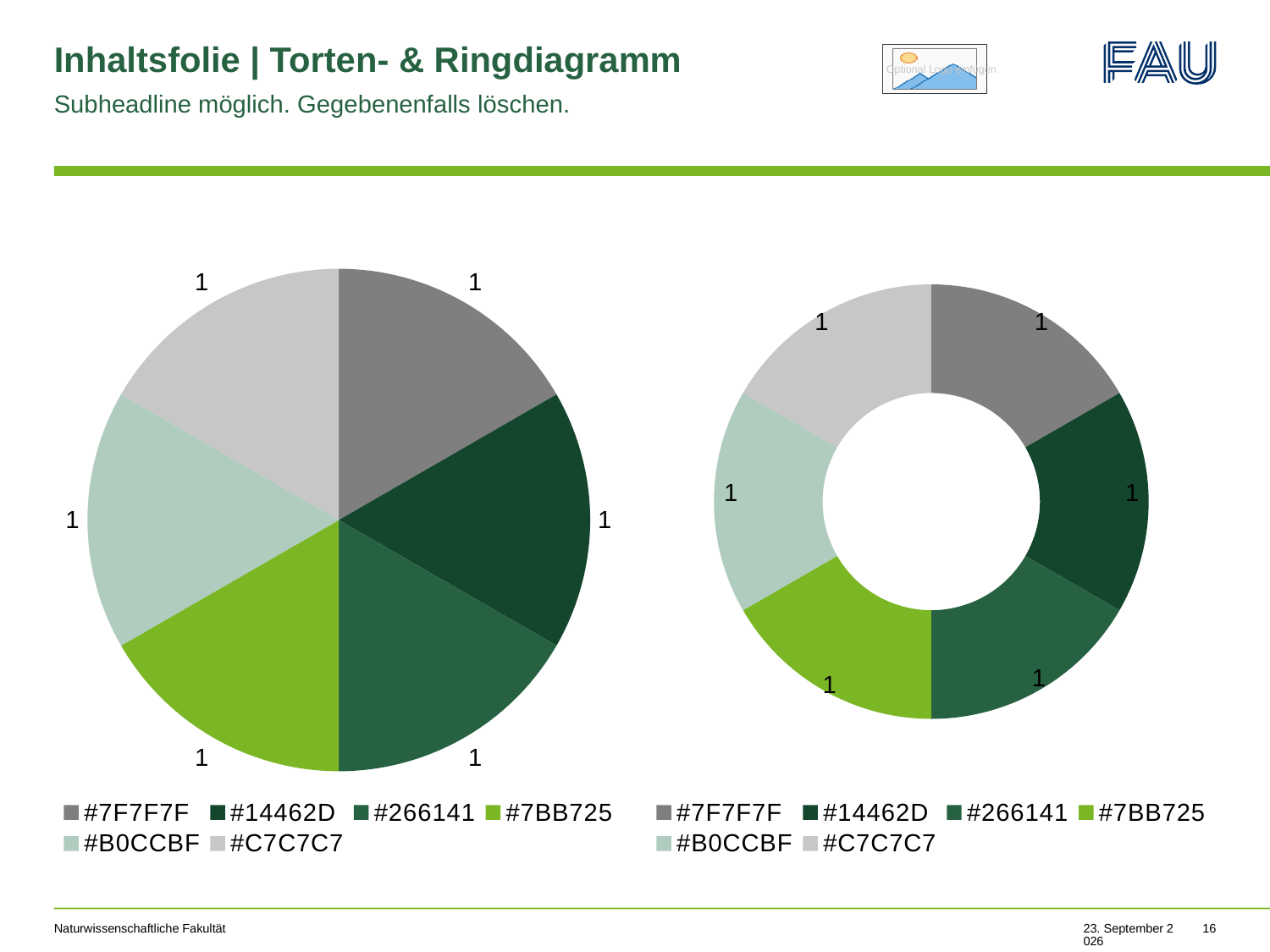
In the doughnut chart on the right, what is the value of the #7BB725 segment? 1 How many entries does the legend of the pie chart on the left list? 6 In the doughnut chart on the right, what is the total of all segment values? 6 In the pie chart on the left, what is the value of the #C7C7C7 slice? 1 In the pie chart on the left, how many slices are there? 6 In the pie chart on the left, what is the difference between the #14462D slice and the #B0CCBF slice? 0 In the doughnut chart on the right, is the #266141 segment larger than, smaller than, or equal to the #7F7F7F segment? equal In the pie chart on the left, what is the total of all slice values? 6 What kind of chart is the chart on the left side of the slide? pie chart In the pie chart on the left, what is the value of the #7F7F7F slice? 1 In the doughnut chart on the right, how many segments are there? 6 What kind of chart is the chart on the right side of the slide? doughnut chart